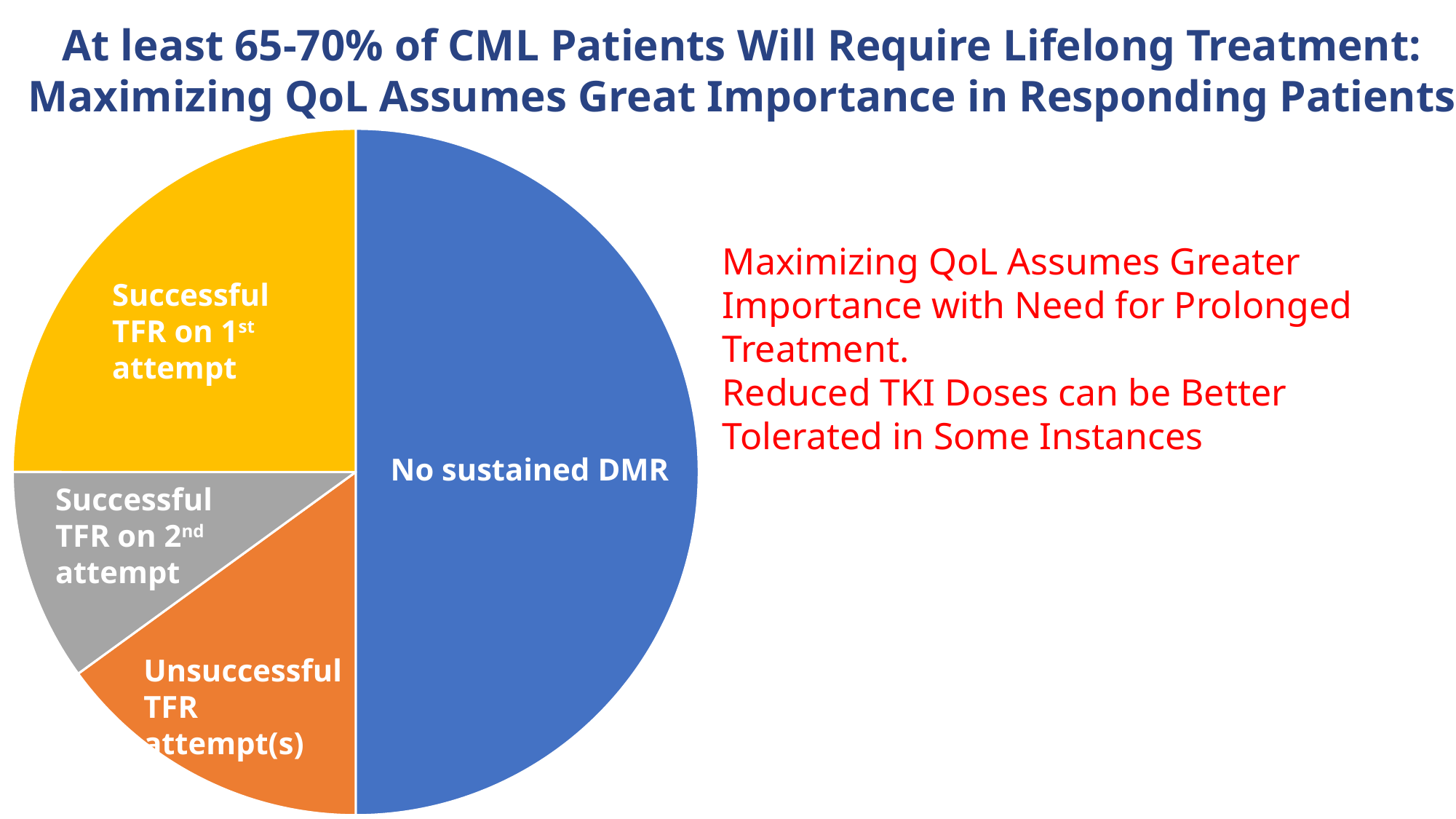
Which slice is larger: No sustained DMR or Successful TFR on 1st attempt? No sustained DMR What colour is the No sustained DMR slice? Blue Which slice of the pie chart is the largest? No sustained DMR Which slice of the pie chart is the smallest? Successful TFR on 2nd attempt What kind of chart is shown on the slide? Pie chart How many slices does the pie chart have? 4 Which slice is larger: Successful TFR on 1st attempt or Unsuccessful TFR attempt(s)? Successful TFR on 1st attempt Which slice is larger: Unsuccessful TFR attempt(s) or Successful TFR on 2nd attempt? Unsuccessful TFR attempt(s) Which slice of the pie chart is coloured yellow? Successful TFR on 1st attempt